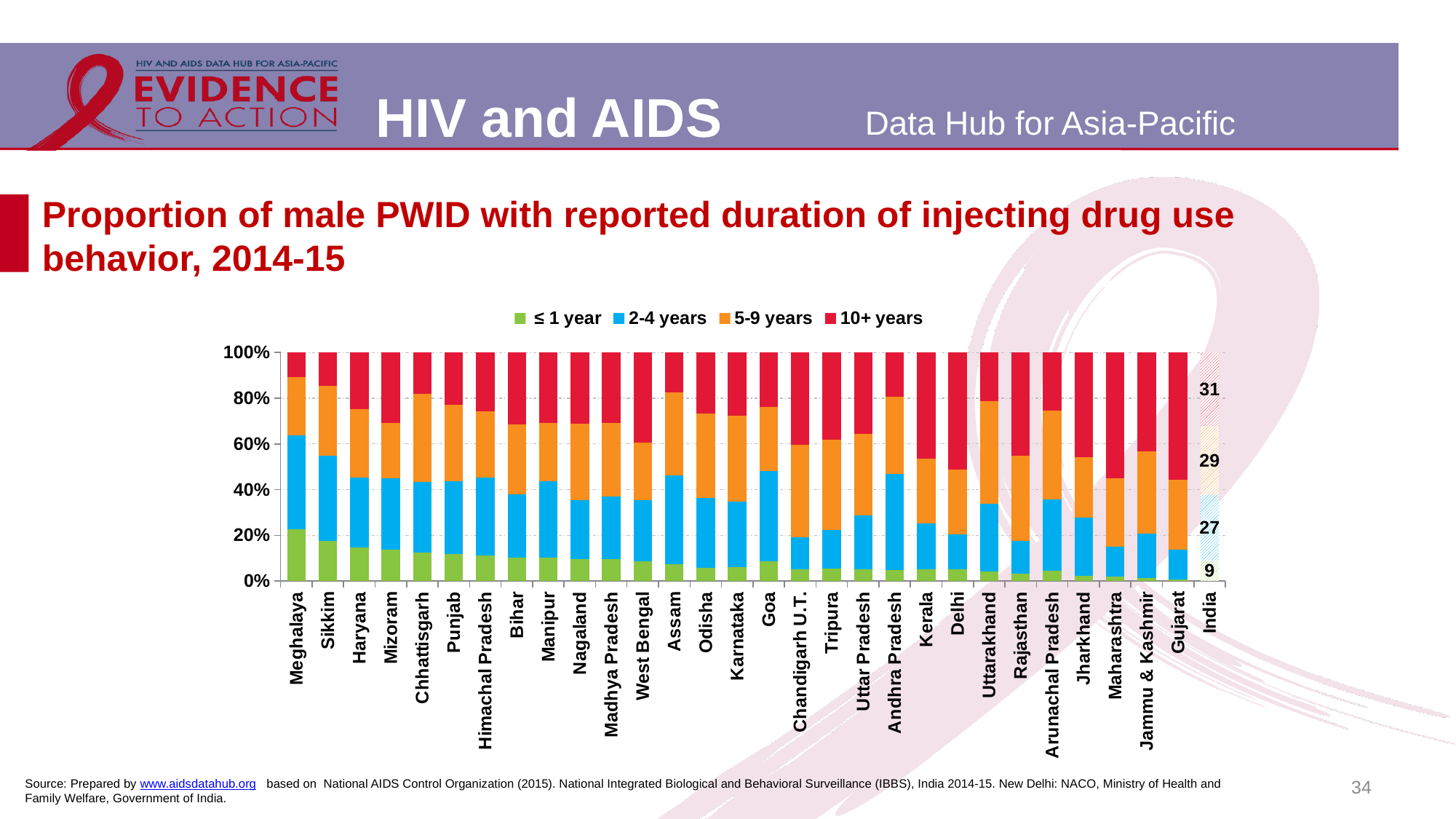
What is the value labelled for the 10+ years segment of the India bar? 31 What colour represents the 10+ years series in the legend? red What is the difference between the 10+ years and ≤ 1 year values labelled on the India bar? 22 Is the combined share of ≤ 1 year and 2-4 years for Meghalaya greater or less than 60%? greater What is the value labelled for the ≤ 1 year segment of the India bar? 9 What is the value labelled for the 5-9 years segment of the India bar? 29 What kind of chart is shown on the slide? stacked bar chart How many categories are plotted along the x axis? 30 Does the ≤ 1 year share generally rise or fall moving from left to right across the states? fall What is the value labelled for the 2-4 years segment of the India bar? 27 Which category has the largest ≤ 1 year segment? Meghalaya How many series does the legend list? 4